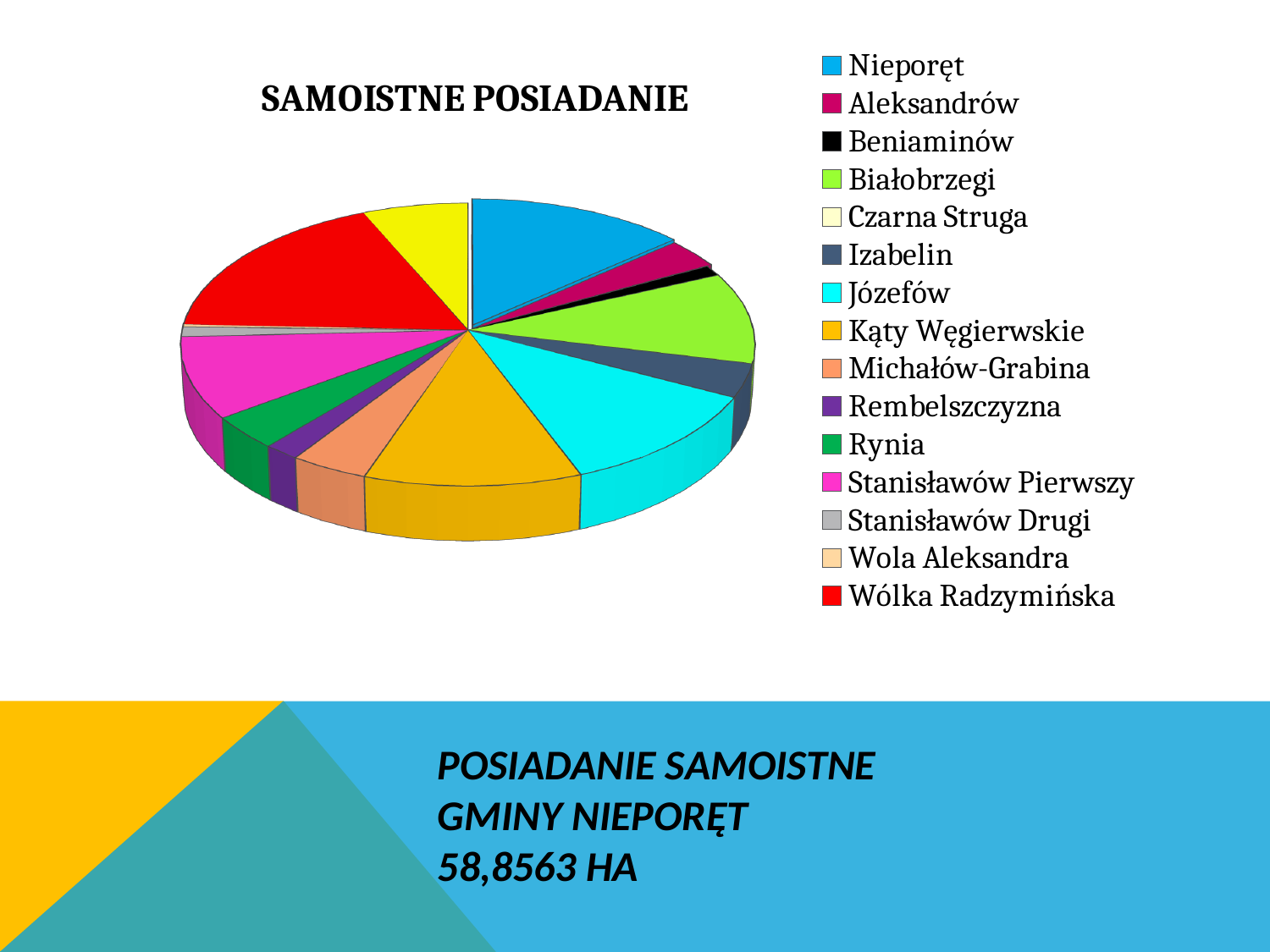
Which slice is larger, Kąty Węgierwskie or Izabelin? Kąty Węgierwskie Which slice is larger, Stanisławów Pierwszy or Stanisławów Drugi? Stanisławów Pierwszy What is the title of the chart? SAMOISTNE POSIADANIE Which slice is larger, Białobrzegi or Rembelszczyzna? Białobrzegi How many categories does the pie chart's legend list? 15 What kind of chart is shown on the slide? pie chart What colour represents Wólka Radzymińska in the pie chart? red